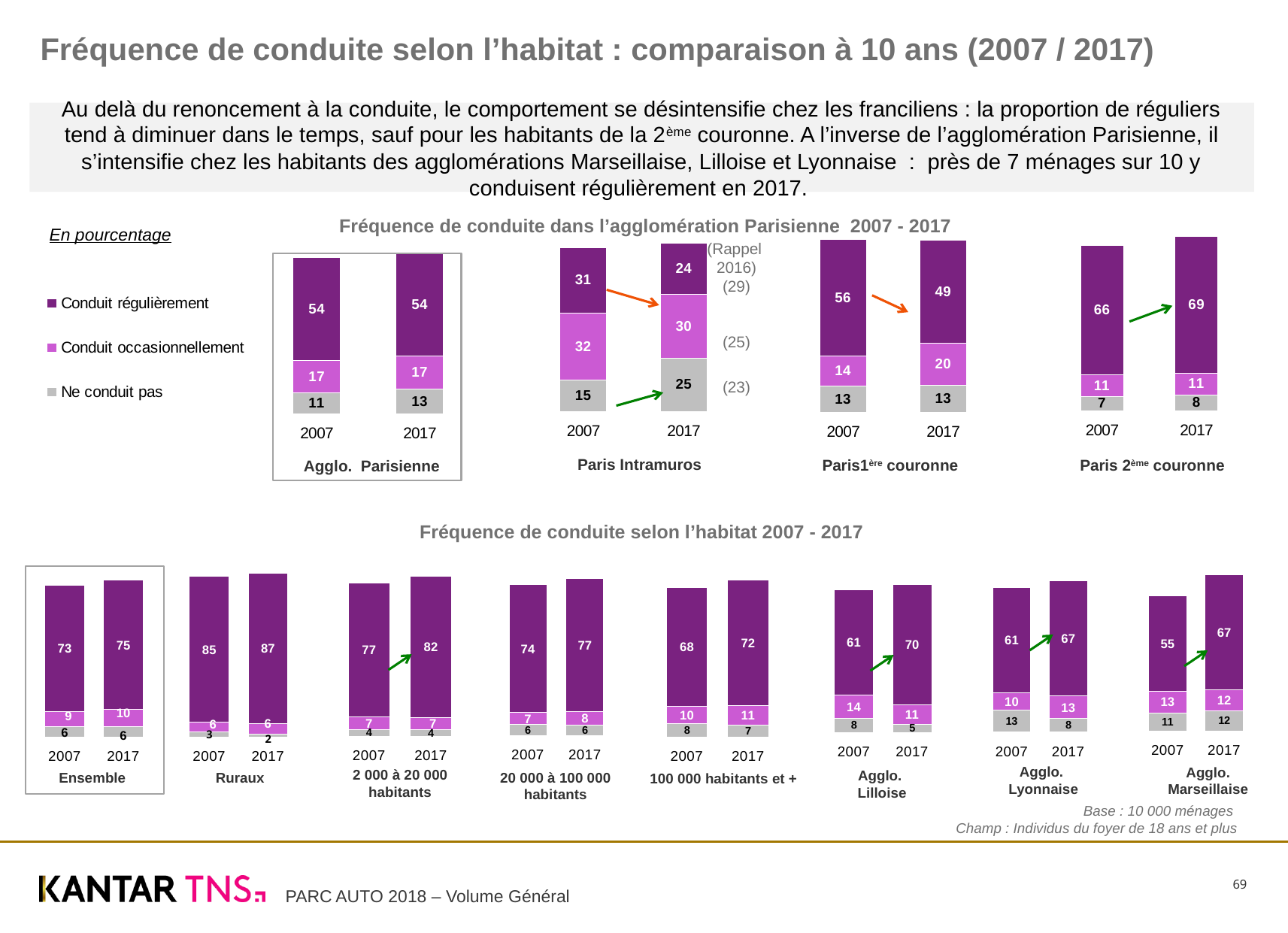
In the Paris 1ère couronne chart, which year has the larger 'Conduit régulièrement' value, 2007 or 2017? 2007 How many series does the legend list? 3 In the Paris Intramuros chart, what is the value for 'Conduit régulièrement' in 2017? 24 In the Agglo. Marseillaise chart, what is the value for 'Conduit régulièrement' in 2007? 55 In the Paris 1ère couronne chart, what is the value for 'Conduit occasionnellement' in 2017? 20 In the Paris 2ème couronne chart, which year has the larger 'Conduit régulièrement' value, 2007 or 2017? 2017 In the Paris Intramuros chart, what is the difference between the 'Ne conduit pas' values for 2017 and 2007? 10 In the Ruraux chart, what is the total of the stacked bar for 2017? 95 In the Agglo. Lilloise chart, what is the difference between the 'Conduit régulièrement' values for 2017 and 2007? 9 In the Agglo. Parisienne chart, what is the total of the stacked bar for 2007? 82 What kind of chart is used for the Ensemble chart? Stacked bar chart In the Agglo. Lyonnaise chart, does the 'Conduit régulièrement' value rise or fall from 2007 to 2017? Rise